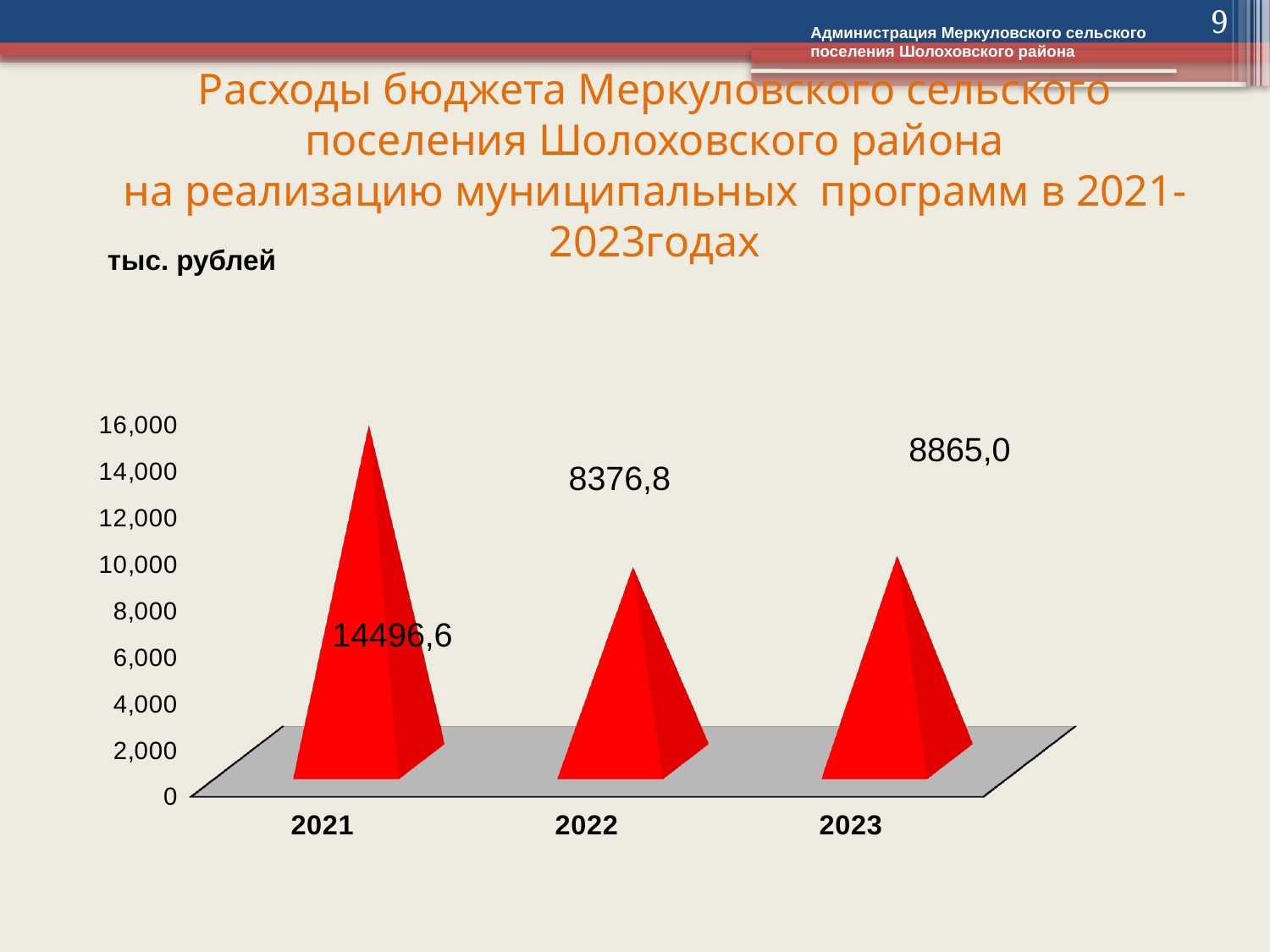
How many years are shown on the x axis? 3 What is the value for 2021? 14496,6 What is the difference between the values for 2023 and 2022? 488,2 What is the value for 2022? 8376,8 What is the value for 2023? 8865,0 What is the difference between the values for 2021 and 2022? 6119,8 Is the value for 2022 greater or less than 10,000? less Which year has the lowest value? 2022 Does the value rise or fall from 2021 to 2022? fall What unit of measurement is indicated above the chart? тыс. рублей Which year has the highest value? 2021 Which is larger, the value for 2022 or the value for 2023? 2023